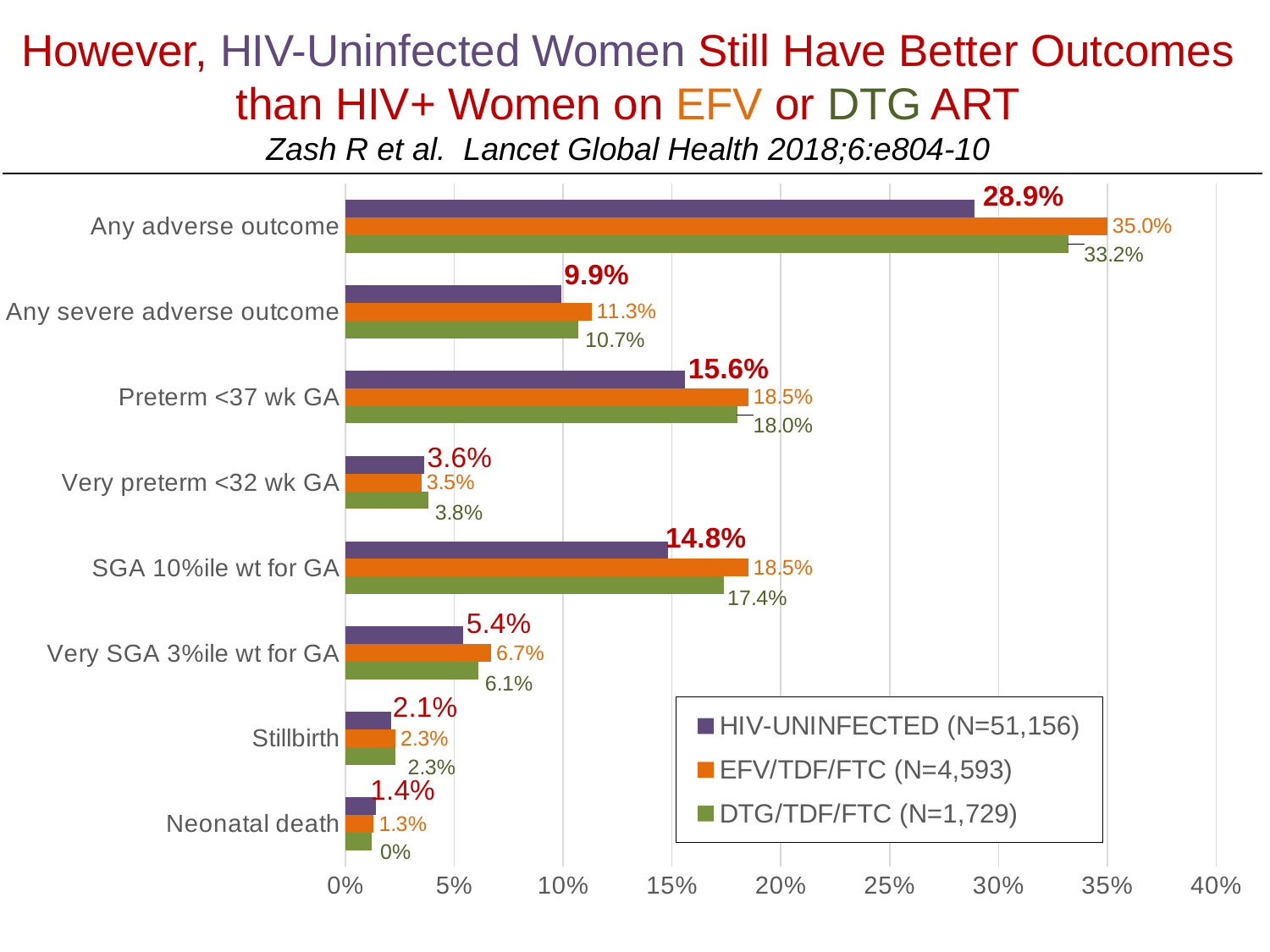
Is the HIV-UNINFECTED value for Any severe adverse outcome greater or less than 10%? less What is the value for EFV/TDF/FTC (N=4,593) for Preterm <37 wk GA? 18.5% How many outcome categories are shown on the chart? 8 What is the value for HIV-UNINFECTED (N=51,156) for Any adverse outcome? 28.9% For SGA 10%ile wt for GA, which is larger: the EFV/TDF/FTC value or the DTG/TDF/FTC value? EFV/TDF/FTC What is the value for DTG/TDF/FTC (N=1,729) for SGA 10%ile wt for GA? 17.4% What is the value for EFV/TDF/FTC (N=4,593) for Very SGA 3%ile wt for GA? 6.7% What is the difference between the EFV/TDF/FTC and HIV-UNINFECTED values for Any adverse outcome? 6.1% What kind of chart is shown on the slide? bar chart Which category has the lowest value for the HIV-UNINFECTED (N=51,156) series? Neonatal death Which category has the highest value for the EFV/TDF/FTC (N=4,593) series? Any adverse outcome How many series does the legend list? 3